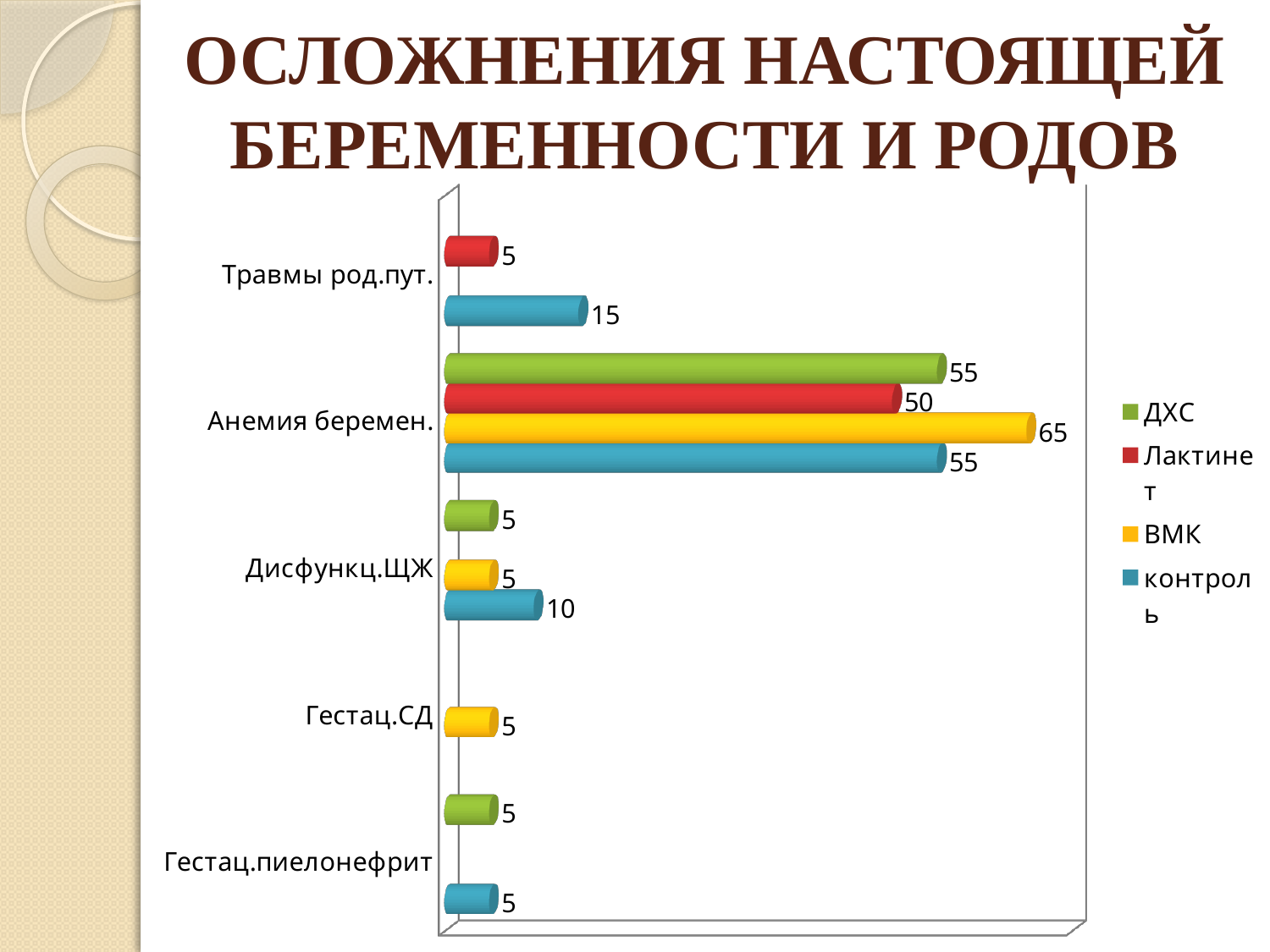
Which is larger in the Дисфункц.ЩЖ category: the контроль value or the ДХС value? контроль What is the value for ВМК in the Анемия беремен. category? 65 What is the value for контроль in the Дисфункц.ЩЖ category? 10 Which series has the lowest value in the Анемия беремен. category? Лактинет What is the difference between the контроль and Лактинет values in the Травмы род.пут. category? 10 What is the difference between the ВМК and Лактинет values in the Анемия беремен. category? 15 What kind of chart is shown on the slide? Bar chart How many series does the legend list? 4 What is the value for Лактинет in the Анемия беремен. category? 50 Which series has the highest value in the Анемия беремен. category? ВМК How many categories are shown on the chart? 5 What is the value for контроль in the Травмы род.пут. category? 15